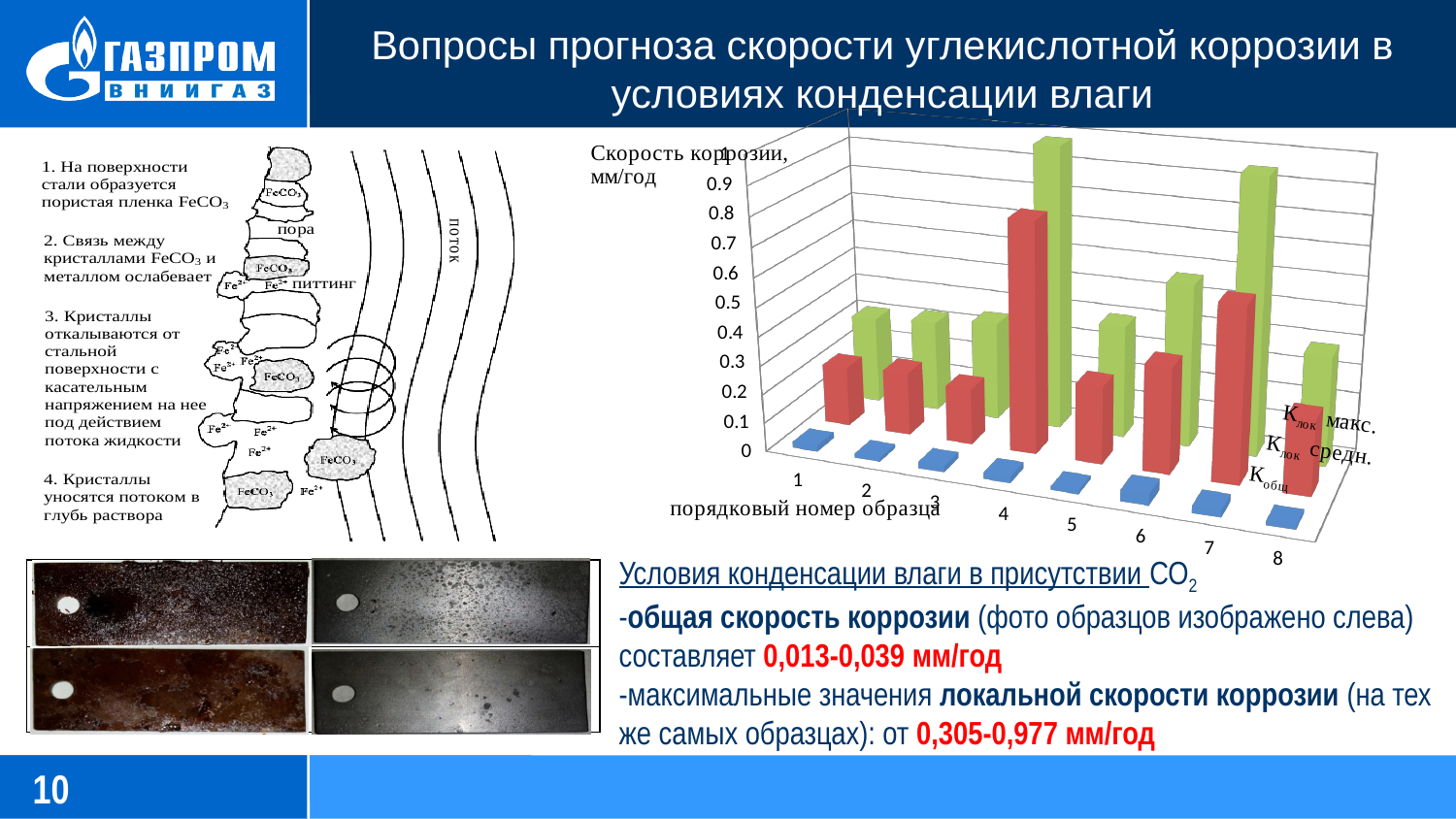
Which series in the chart is drawn in blue? Kобщ How many sample numbers (порядковый номер образца) are shown along the x axis of the chart? 8 For which sample number is the Kлок средн. (red) bar the highest? 4 Is the Kобщ value for sample 1 greater or less than 0.1? less Is the Kлок средн. value for sample 4 greater or less than 0.5? greater What kind of chart is shown on the slide? bar chart Which is larger: the Kлок макс. value for sample 7 or for sample 6? sample 7 For which sample number is the Kлок макс. (green) bar the highest? 4 What is the label of the vertical axis of the chart? Скорость коррозии, мм/год Is the Kлок макс. value for sample 4 greater or less than 0.8? greater Which is larger: the Kлок макс. value for sample 4 or for sample 8? sample 4